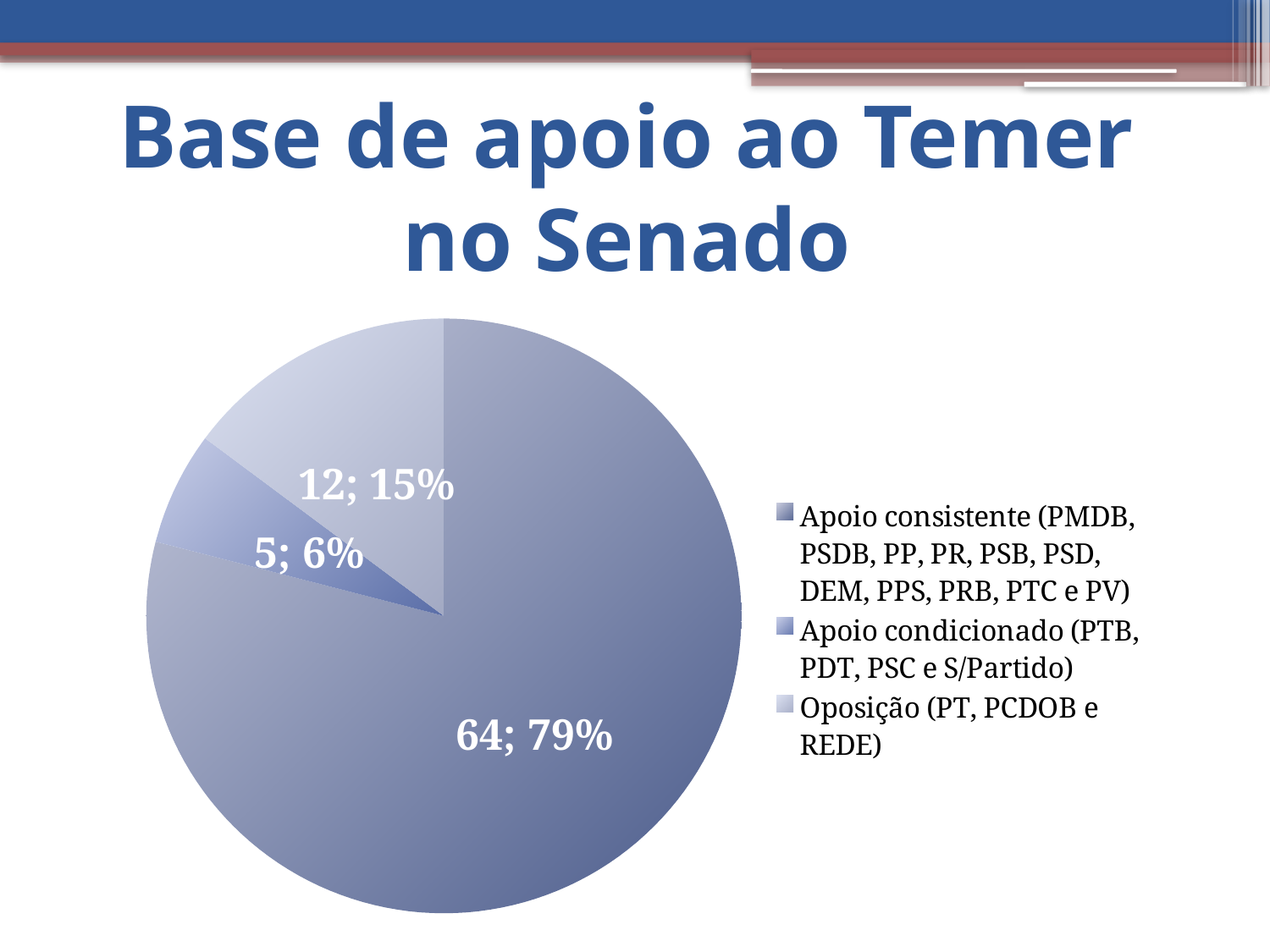
What is the difference in count between the 'Apoio consistente' slice and the 'Oposição' slice? 52 What percentage share does the 'Apoio consistente' slice have? 79% What kind of chart is shown on the slide? pie chart What is the title of the chart slide? Base de apoio ao Temer no Senado How many senators are in the 'Apoio consistente' slice? 64 What percentage share does the 'Oposição' slice have? 15% How many senators are in the 'Apoio condicionado' slice? 5 Which is larger, the 'Oposição' slice or the 'Apoio condicionado' slice? Oposição Which slice is the largest? Apoio consistente How many entries does the legend list? 3 Which slice is the smallest? Apoio condicionado How many slices does the pie chart have? 3